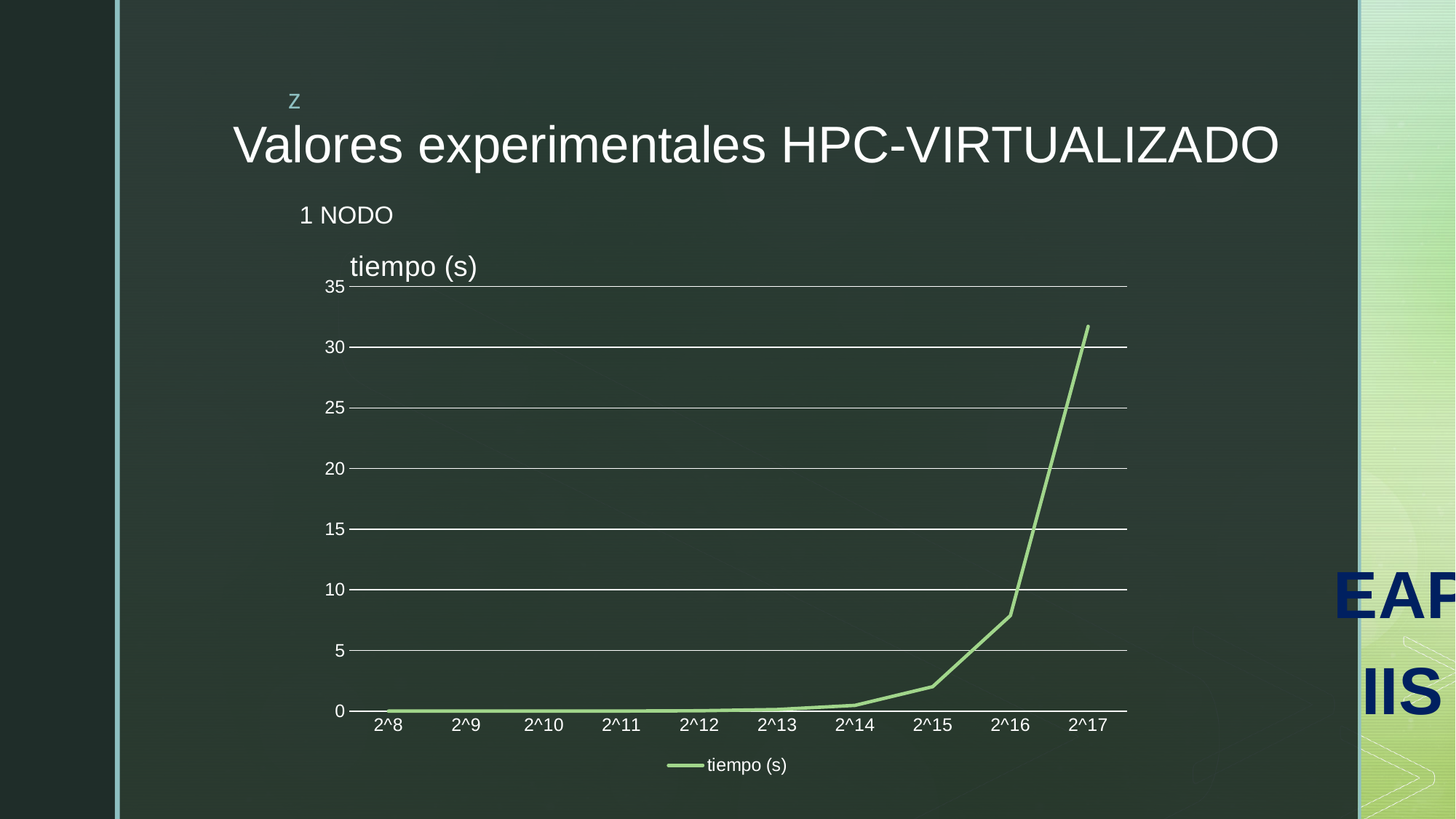
Which has a larger value, 2^16 or 2^17? 2^17 How many series does the legend list? 1 How many points are plotted along the x axis? 10 Is the value for 2^16 greater or less than 5? greater What is the label shown in the legend? tiempo (s) What kind of chart is shown on the slide? line chart Is the value for 2^17 greater or less than 30? greater Is the value for 2^16 greater or less than 10? less What is the title of the chart? tiempo (s) Do the values rise or fall as the x axis goes from 2^8 to 2^17? rise Which x-axis category has the highest value for tiempo (s)? 2^17